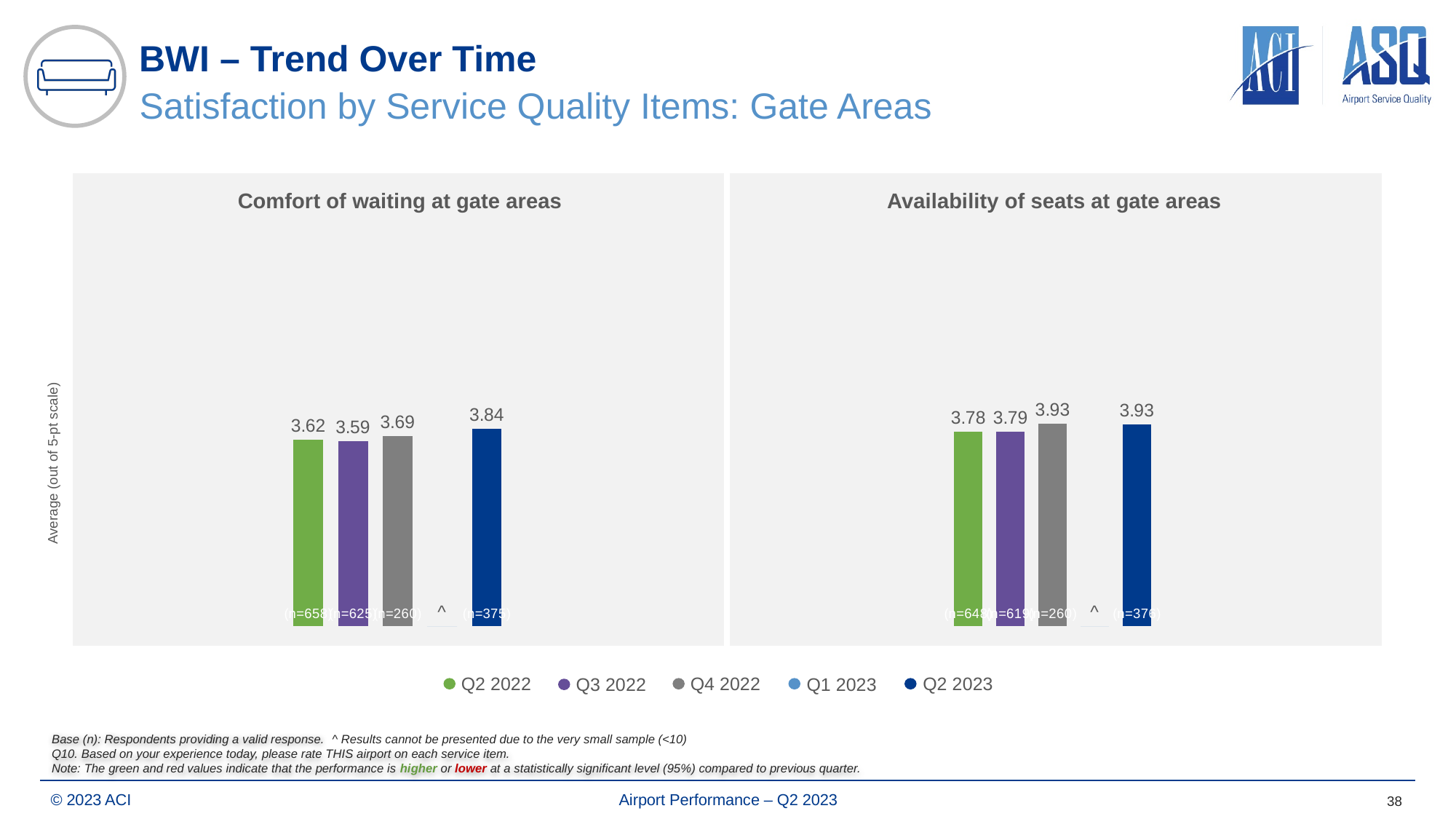
In the 'Comfort of waiting at gate areas' chart, what is the difference between the Q2 2023 value and the Q4 2022 value? 0.15 In the 'Comfort of waiting at gate areas' chart, what is the value for Q2 2023? 3.84 In the 'Comfort of waiting at gate areas' chart, which quarter has the lowest value? Q3 2022 How many series does the legend list? 5 In the 'Availability of seats at gate areas' chart, what is the value for Q2 2022? 3.78 In the 'Availability of seats at gate areas' chart, what is the difference between the Q4 2022 value and the Q2 2022 value? 0.15 In the 'Comfort of waiting at gate areas' chart, which quarter has the highest value? Q2 2023 In the 'Comfort of waiting at gate areas' chart, which is larger, the value for Q2 2022 or the value for Q4 2022? Q4 2022 In the 'Comfort of waiting at gate areas' chart, what is the value for Q3 2022? 3.59 In the 'Availability of seats at gate areas' chart, which quarter has the lowest value? Q2 2022 In the 'Availability of seats at gate areas' chart, what is the value for Q4 2022? 3.93 What kind of chart is the 'Availability of seats at gate areas' chart? Bar chart